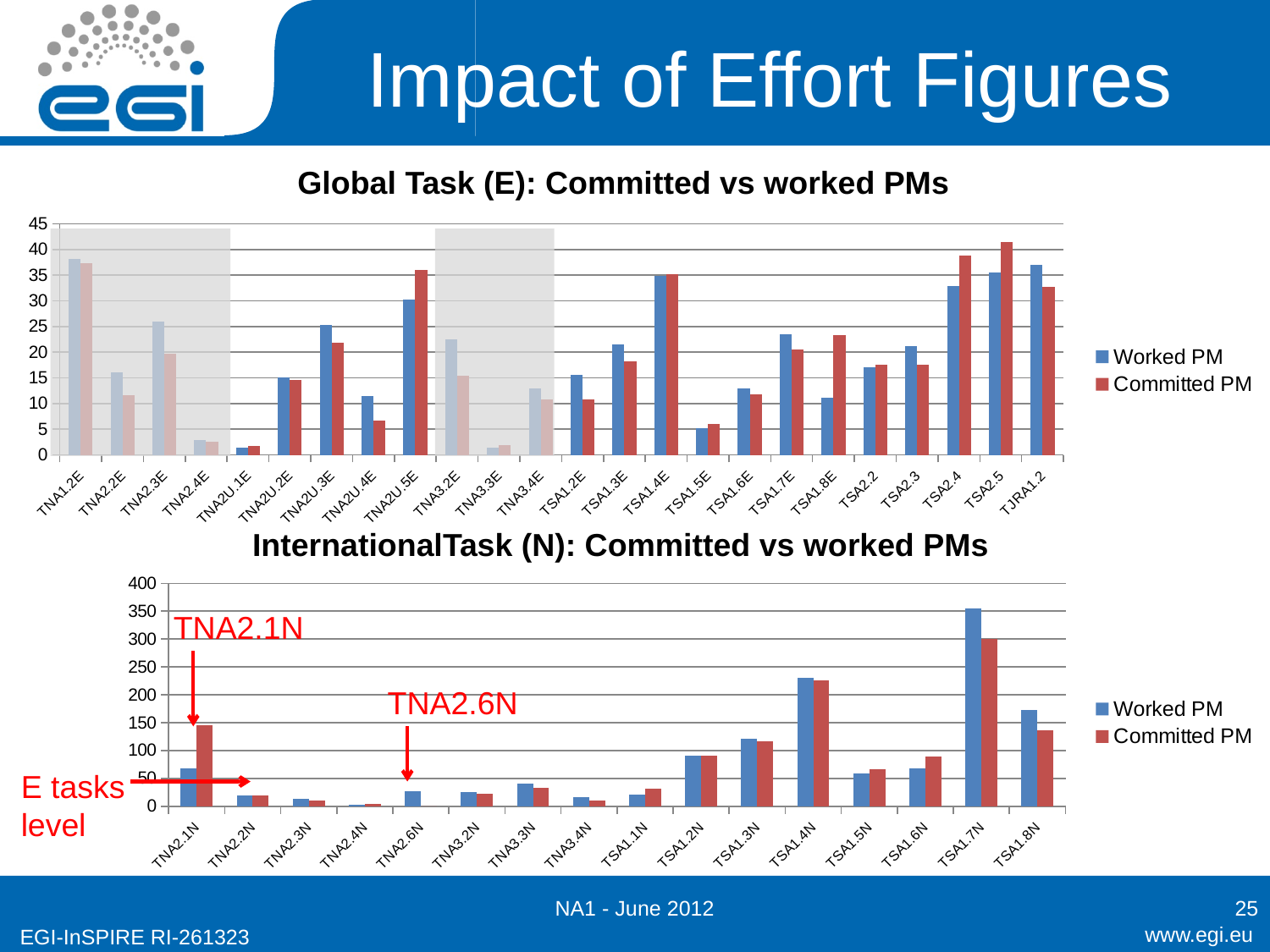
How many series does the legend of the 'InternationalTask (N): Committed vs worked PMs' chart list? 2 In the 'InternationalTask (N): Committed vs worked PMs' chart, is the Committed PM value for TNA2.1N greater or less than 100? greater In the 'Global Task (E): Committed vs worked PMs' chart, is the Committed PM value for TNA2U.5E greater or less than 30? greater How many categories are shown on the x axis of the 'Global Task (E): Committed vs worked PMs' chart? 24 In the 'Global Task (E): Committed vs worked PMs' chart, which is larger for TSA1.8E: Worked PM or Committed PM? Committed PM What type of chart is the 'Global Task (E): Committed vs worked PMs' chart? bar chart In the 'Global Task (E): Committed vs worked PMs' chart, which category has the highest Committed PM value? TSA2.5 What are the two series names in the legend of the 'Global Task (E): Committed vs worked PMs' chart? Worked PM and Committed PM In the 'Global Task (E): Committed vs worked PMs' chart, is the Worked PM value for TSA1.5E greater or less than 10? less In the 'InternationalTask (N): Committed vs worked PMs' chart, which category has the highest Worked PM value? TSA1.7N How many categories are shown on the x axis of the 'InternationalTask (N): Committed vs worked PMs' chart? 16